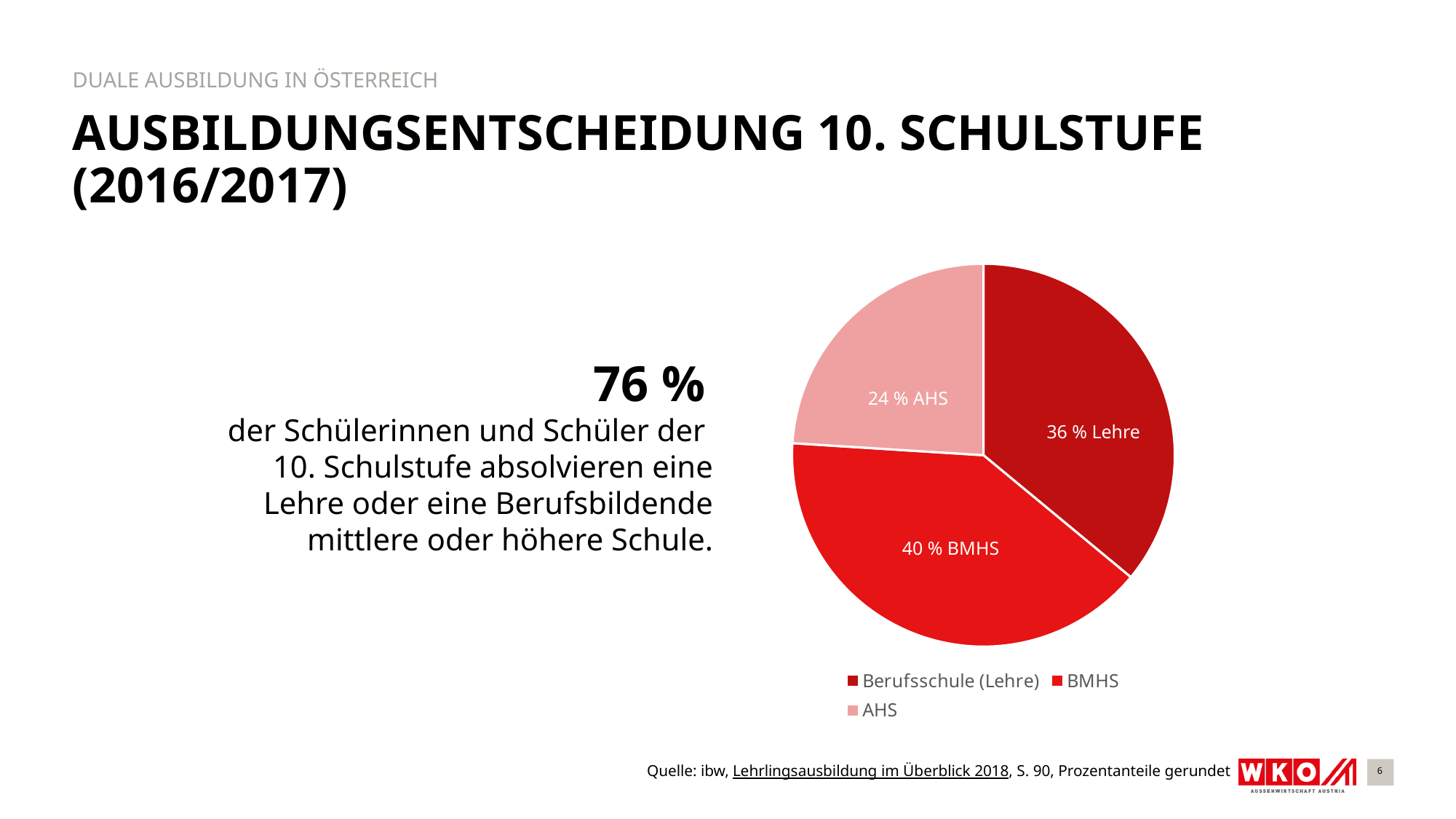
What share of the pie does Lehre (Berufsschule) have? 36 % How many entries does the legend list? 3 Which category has the smallest slice of the pie? AHS Which category has the largest slice of the pie? BMHS What share of the pie does BMHS have? 40 % What is the difference in percentage points between the BMHS slice and the AHS slice? 16 What kind of chart is shown on the slide? pie chart How many slices does the pie chart have? 3 What share of the pie does AHS have? 24 % What is the difference in percentage points between the BMHS slice and the Lehre slice? 4 Which is larger, the Lehre slice or the AHS slice? Lehre Which legend entry is shown in the lightest pink colour? AHS